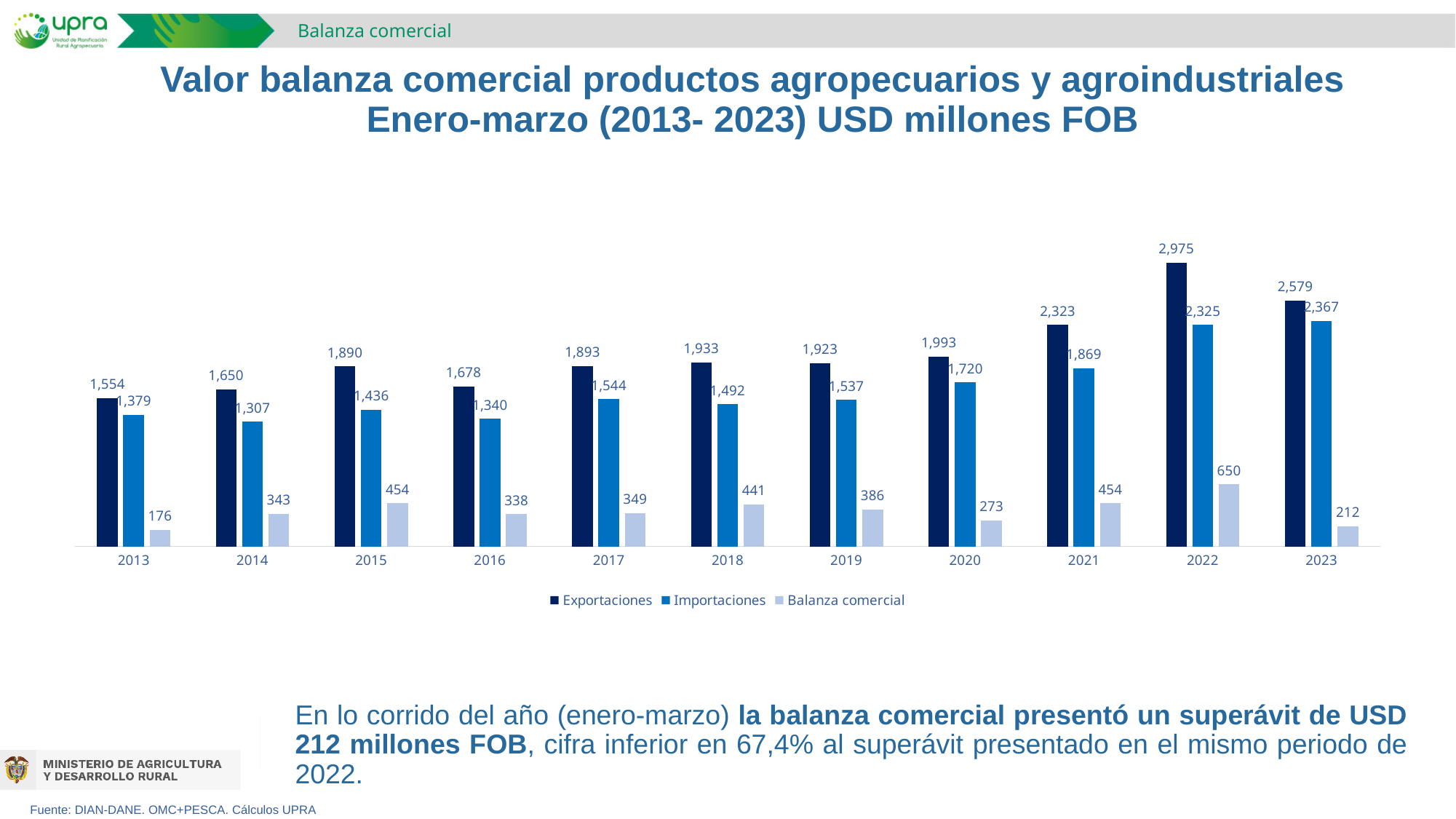
What is the difference between Exportaciones and Importaciones in 2021? 454 What is the value of Exportaciones in 2022? 2,975 Which is larger in 2019, Exportaciones or Importaciones? Exportaciones What is the value of Balanza comercial in 2023? 212 Did the Balanza comercial value rise or fall from 2022 to 2023? Fall Which year has the highest Exportaciones value? 2022 How many years are shown on the x axis? 11 What kind of chart is shown on the slide? Bar chart What is the third series listed in the legend? Balanza comercial What is the value of Importaciones in 2016? 1,340 How many series does the legend list? 3 Which year has the lowest Balanza comercial value? 2013